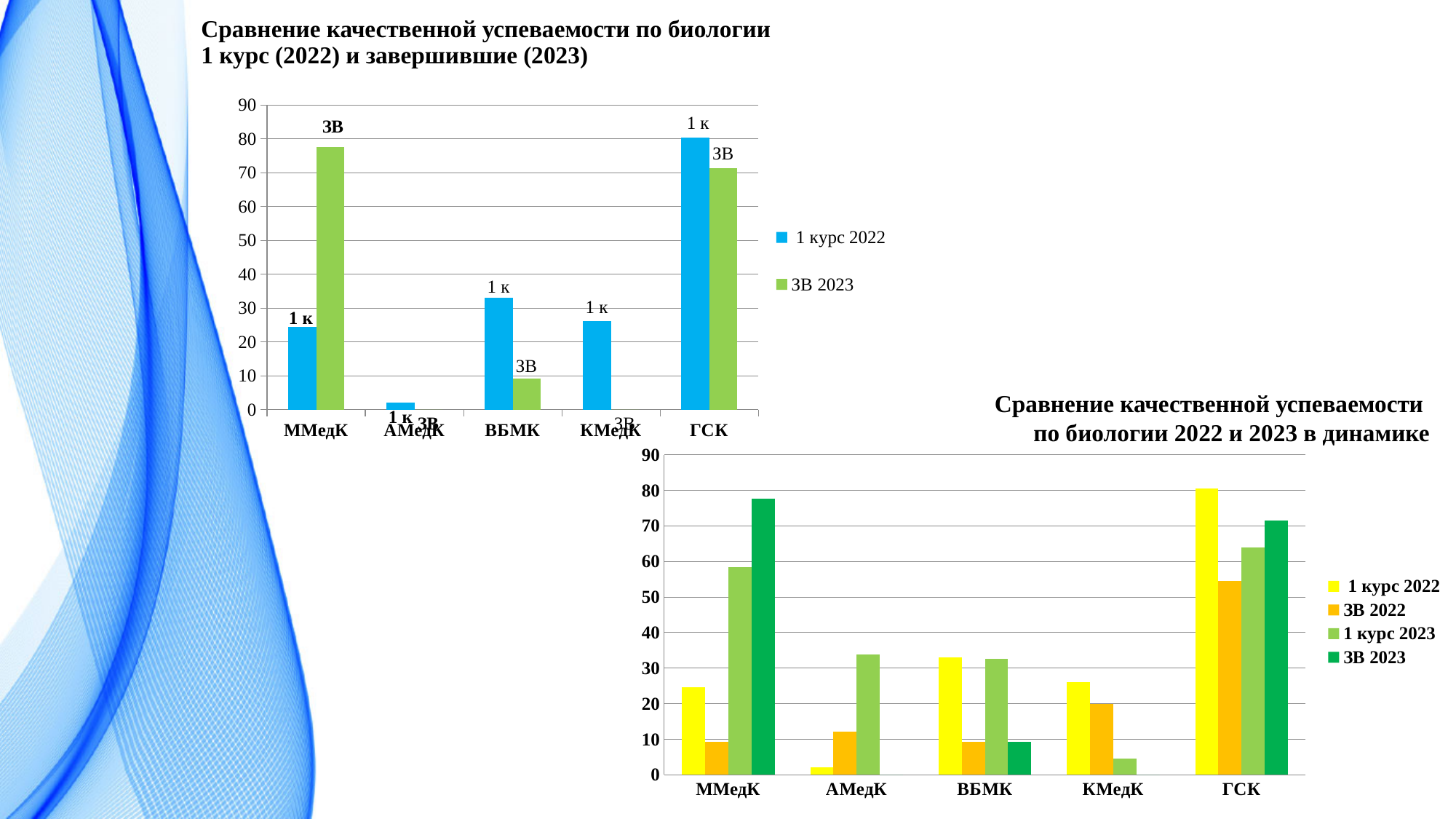
In the bottom-right chart, for ММедК, which series has the larger value: '1 курс 2022' or '1 курс 2023'? 1 курс 2023 What kind of chart is the top-left chart titled 'Сравнение качественной успеваемости по биологии 1 курс (2022) и завершившие (2023)'? Bar chart In the top-left chart, which category has the highest value for the series '1 курс 2022'? ГСК In the bottom-right chart, is the value for ГСК in the series 'ЗВ 2022' greater or less than 50? greater In the bottom-right chart, which category has the highest value for the series '1 курс 2023'? ГСК In the top-left chart, how many series does the legend list? 2 In the bottom-right chart, how many categories are shown on the x axis? 5 In the top-left chart, is the value for ММедК in the series 'ЗВ 2023' greater or less than 70? greater In the top-left chart, which category has the lowest value for the series '1 курс 2022'? АМедК In the bottom-right chart, what colour represents the series '1 курс 2022' in the legend? Yellow In the bottom-right chart titled 'Сравнение качественной успеваемости по биологии 2022 и 2023 в динамике', how many series does the legend list? 4 In the top-left chart, for ГСК, which series has the larger value: '1 курс 2022' or 'ЗВ 2023'? 1 курс 2022